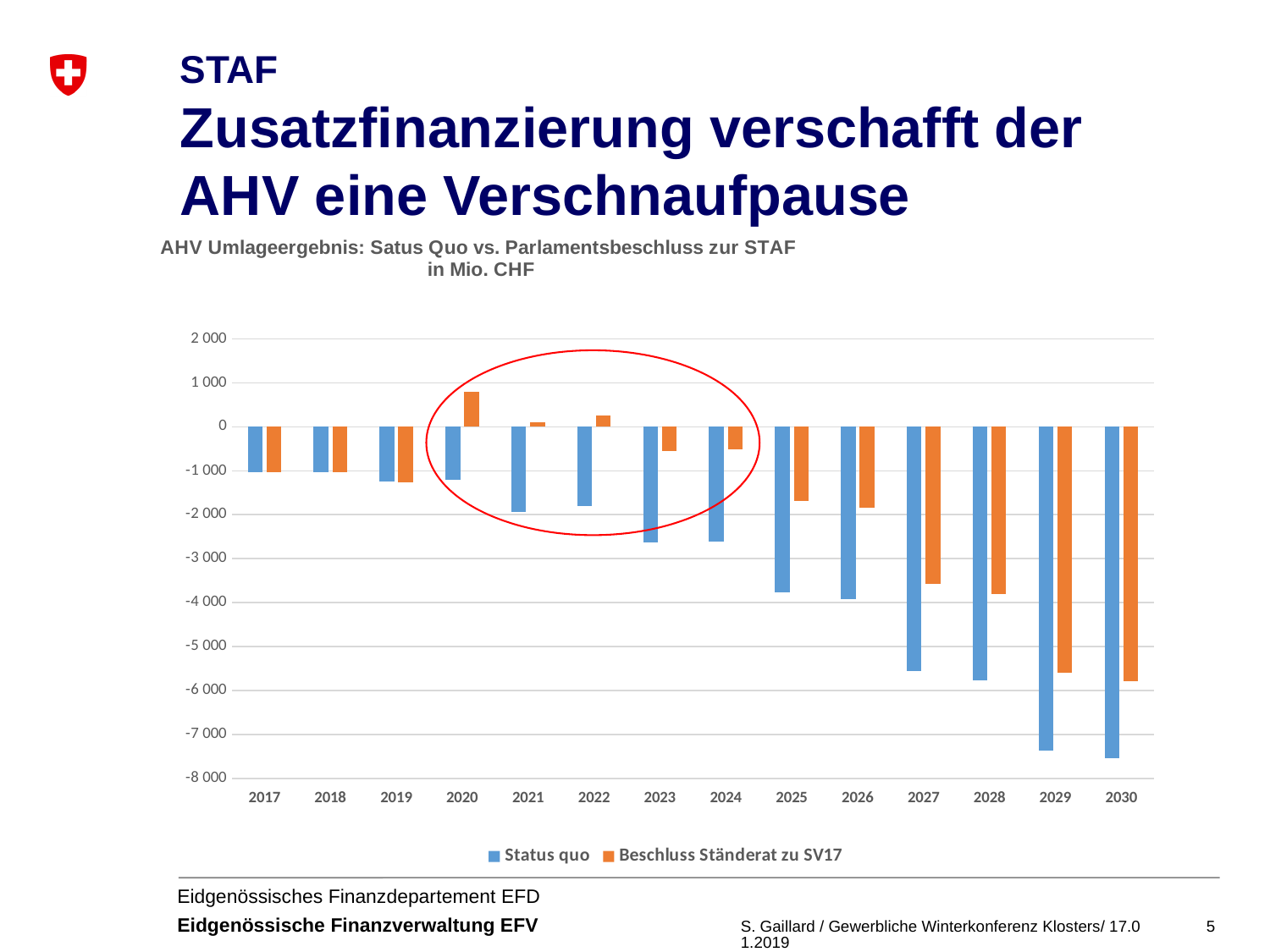
Is the Beschluss Ständerat zu SV17 value for 2020 greater or less than 0? greater Which year has the highest value for the Beschluss Ständerat zu SV17 series? 2020 Is the Status quo value for 2025 greater or less than -3 000? less In how many years is the Beschluss Ständerat zu SV17 value positive? 3 How many series does the legend list? 2 What are the two series named in the legend? Status quo; Beschluss Ständerat zu SV17 Is the Status quo value for 2030 greater or less than -7 000? less What kind of chart is shown on the slide? bar chart In 2023, which series has the higher value, Status quo or Beschluss Ständerat zu SV17? Beschluss Ständerat zu SV17 Do the Status quo values rise or fall from 2017 to 2030? fall How many years are shown on the x axis of the chart? 14